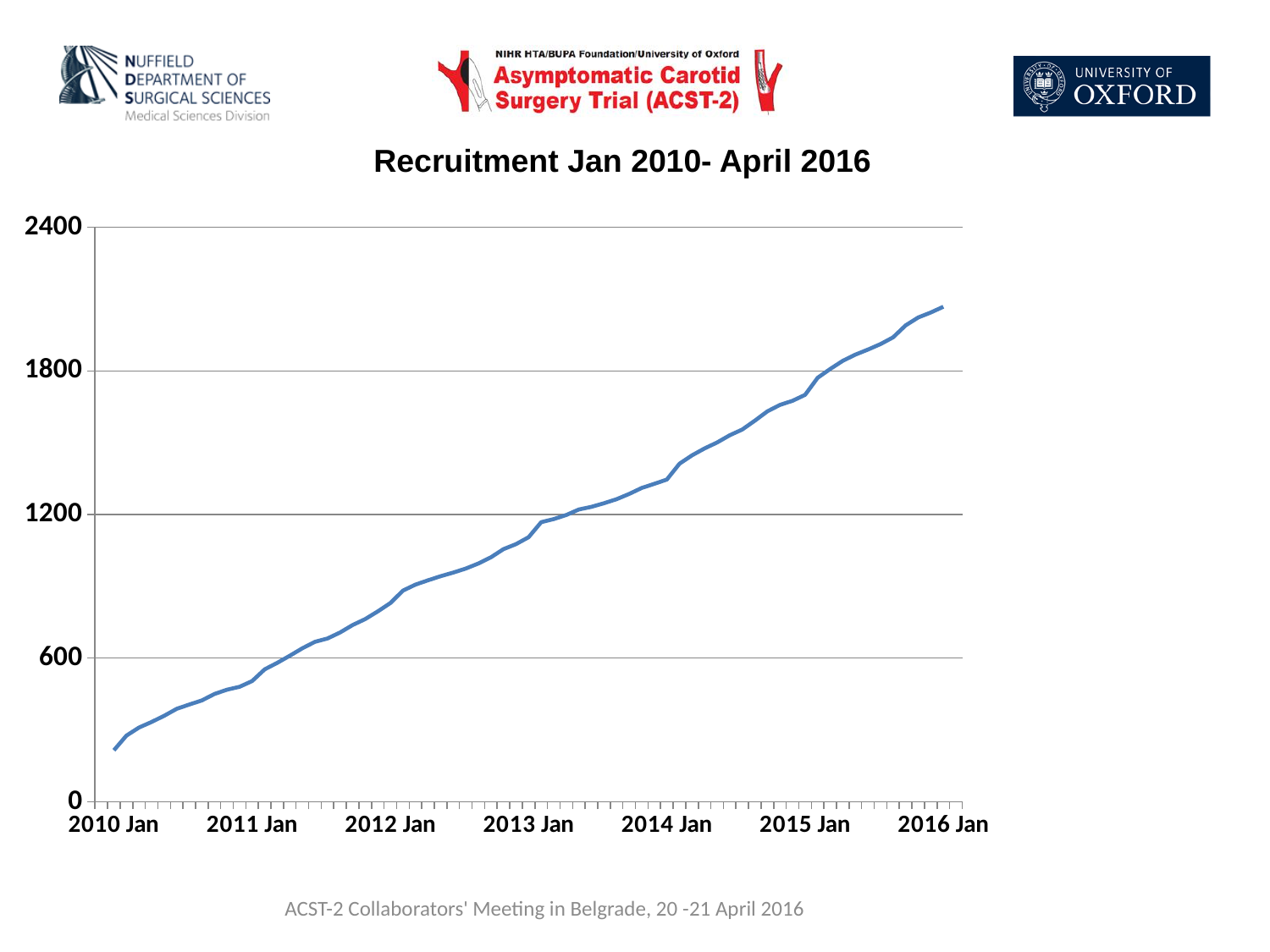
Is the value at 2013 Jan greater or less than 1200? less At which x-axis label is the plotted value lowest? 2010 Jan Is the value at 2010 Jan greater or less than 600? less Which is larger, the value at 2012 Jan or the value at 2014 Jan? 2014 Jan Is the value at 2012 Jan greater or less than 600? greater Do the recruitment values rise or fall over time along the x axis? rise What kind of chart is shown on the slide? line chart What is the title of the chart? Recruitment Jan 2010- April 2016 What is the highest value shown on the y axis? 2400